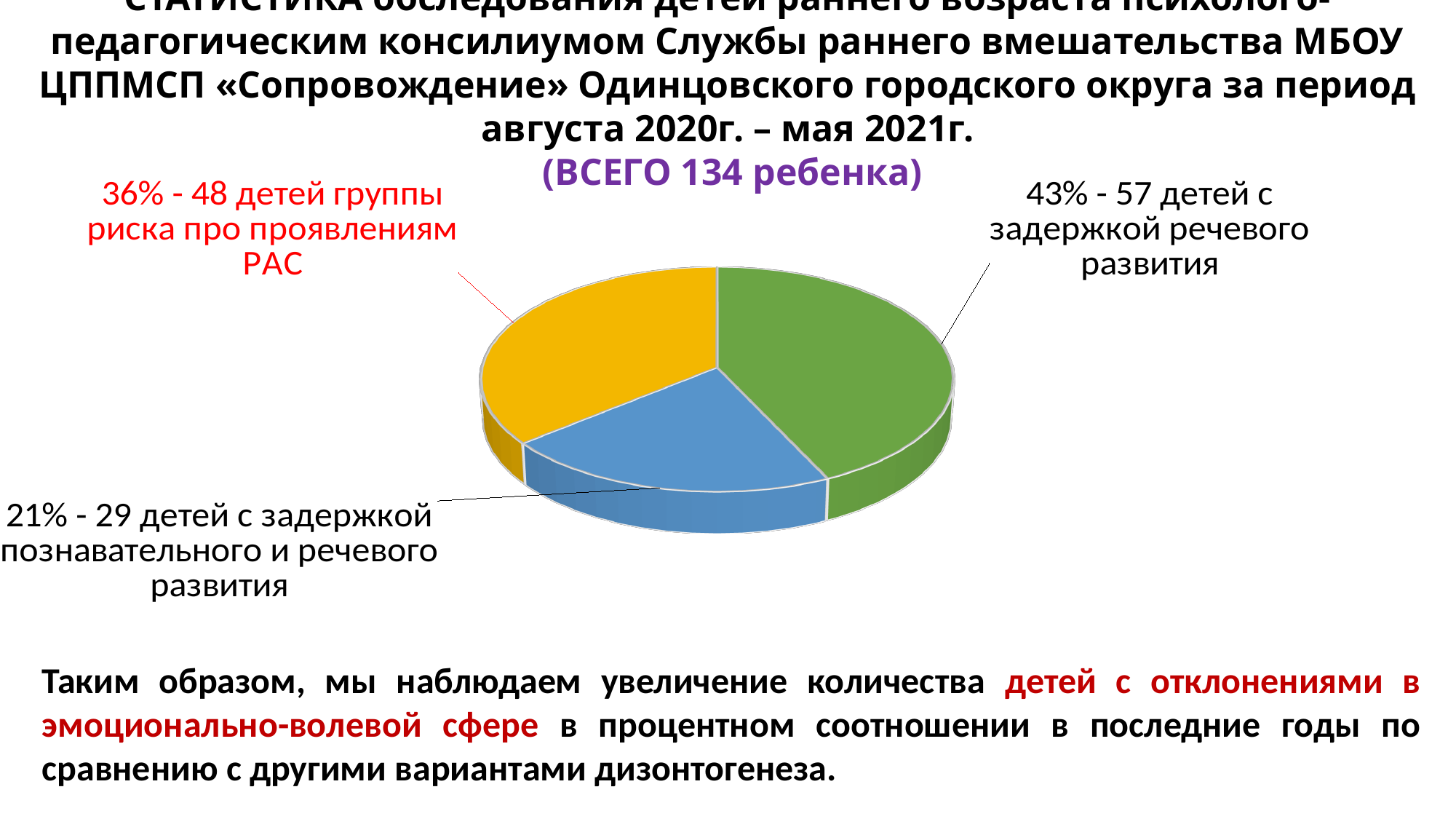
Какая группа больше: дети группы риска по проявлениям РАС или дети с задержкой познавательного и речевого развития? Дети группы риска по проявлениям РАС Какая категория имеет наибольшую долю на диаграмме? Дети с задержкой речевого развития Сколько детей с задержкой речевого развития указано на диаграмме? 57 Сколько секторов (категорий) на круговой диаграмме? 3 Какая категория имеет наименьшую долю на диаграмме? Дети с задержкой познавательного и речевого развития Какой процент детей с задержкой речевого развития показан на диаграмме? 43% Какой процент составляют дети с задержкой познавательного и речевого развития? 21% Сколько детей группы риска по проявлениям РАС указано на диаграмме? 48 Какой тип диаграммы показан на слайде? Круговая диаграмма Сколько всего детей обследовано согласно заголовку слайда? 134 Каким цветом на диаграмме показан сектор детей с задержкой речевого развития? Зелёным На сколько детей больше в группе с задержкой речевого развития, чем в группе риска по проявлениям РАС? 9